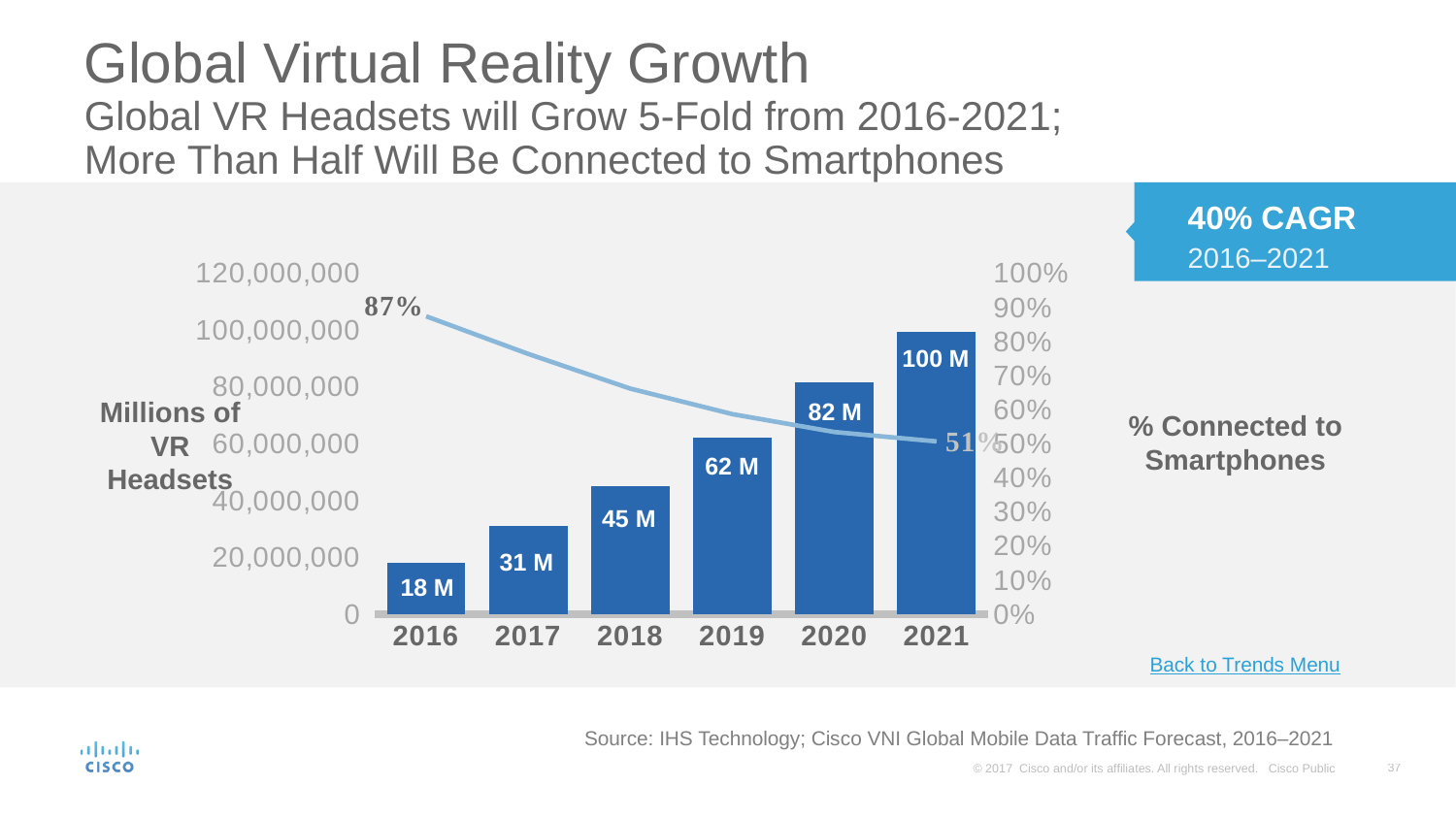
How many years are shown on the x axis? 6 What is the value for VR headsets in 2016? 18 M Which year has the lowest number of VR headsets? 2016 Do the VR headset bars rise or fall from 2016 to 2021? rise Which year has more VR headsets, 2017 or 2019? 2019 What is the difference in VR headsets between 2020 and 2019? 20 M What is the value for VR headsets in 2018? 45 M What percentage of VR headsets are connected to smartphones in 2016, according to the line label? 87% What is the value for VR headsets in 2021? 100 M What is the CAGR shown in the callout box for 2016–2021? 40% What percentage of VR headsets are connected to smartphones in 2021, according to the line label? 51% Which year has the highest number of VR headsets? 2021